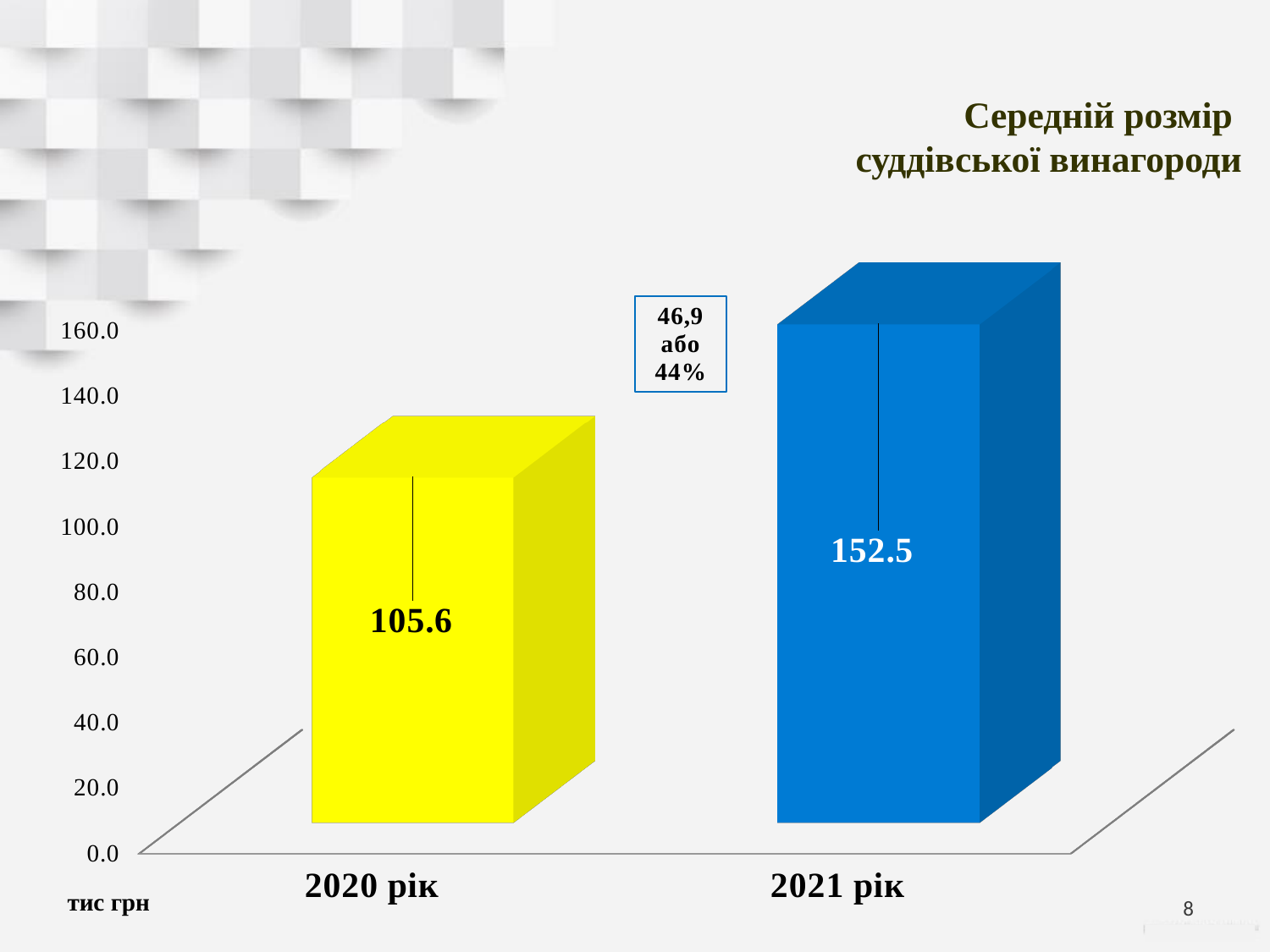
Is the value for 2020 рік greater or less than 120.0? less What is the value for 2021 рік? 152.5 Is the value for 2021 рік larger or smaller than the value for 2020 рік? larger How many categories are shown on the x axis? 2 What percentage increase is shown in the text box between the bars? 44% What kind of chart is shown on the slide? bar chart Which year has the lower value? 2020 рік What is the value for 2020 рік? 105.6 What is the difference between the values for 2021 рік and 2020 рік? 46.9 Is the value for 2021 рік greater or less than 140.0? greater Which year has the higher value? 2021 рік Do the values rise or fall from 2020 рік to 2021 рік? rise